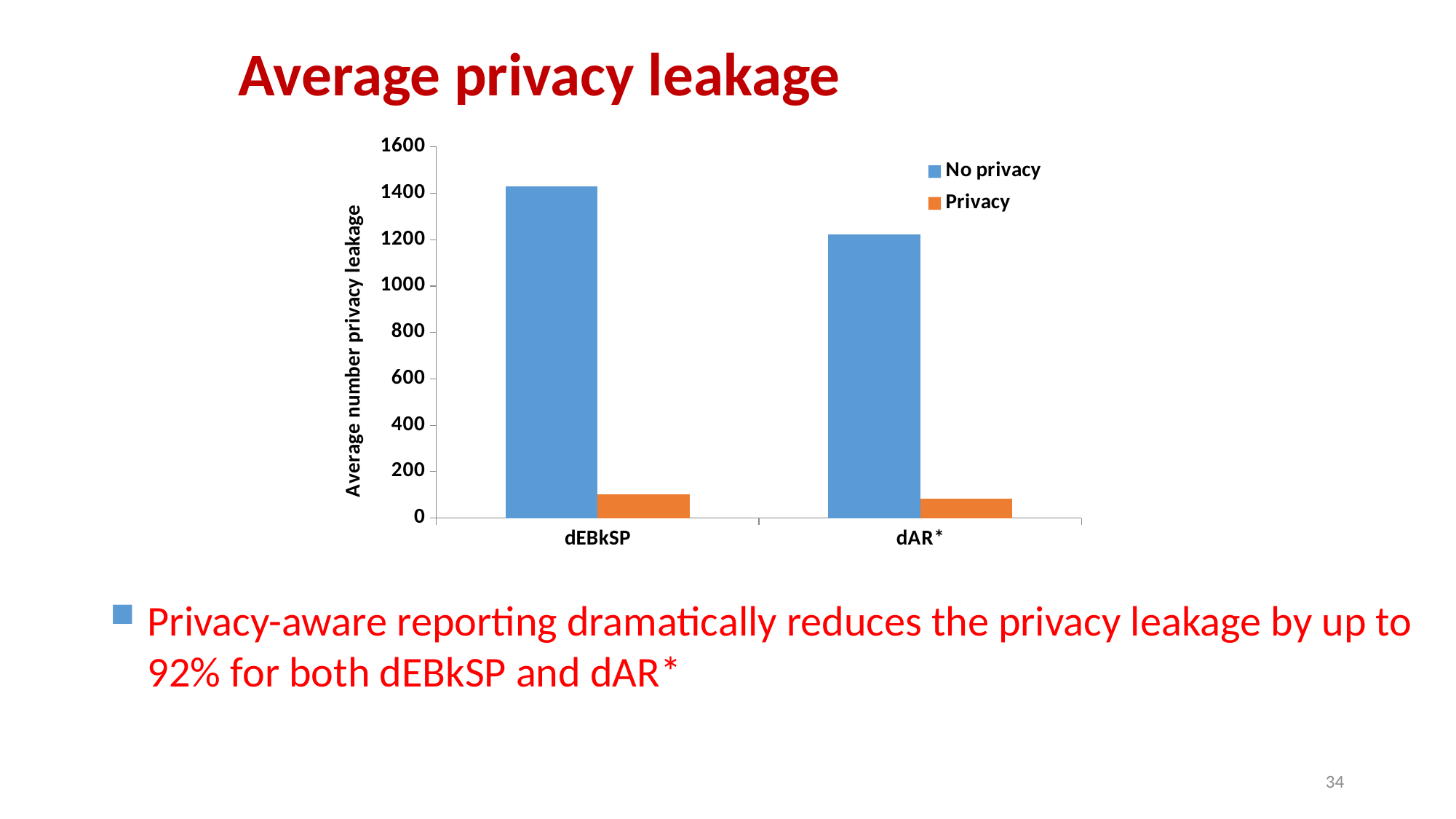
Is the Privacy value for dEBkSP greater or less than 200? less What is the label of the y axis? Average number privacy leakage What kind of chart is shown on the slide? bar chart Is the No privacy value for dEBkSP greater or less than 1200? greater Which bar is the tallest in the chart? No privacy for dEBkSP Is the No privacy value for dAR* greater or less than 1400? less How many categories are shown on the x axis? 2 Which category has the higher No privacy value, dEBkSP or dAR*? dEBkSP How many series does the legend list? 2 What colour represents the Privacy series? orange Which series has the higher value for dEBkSP, No privacy or Privacy? No privacy